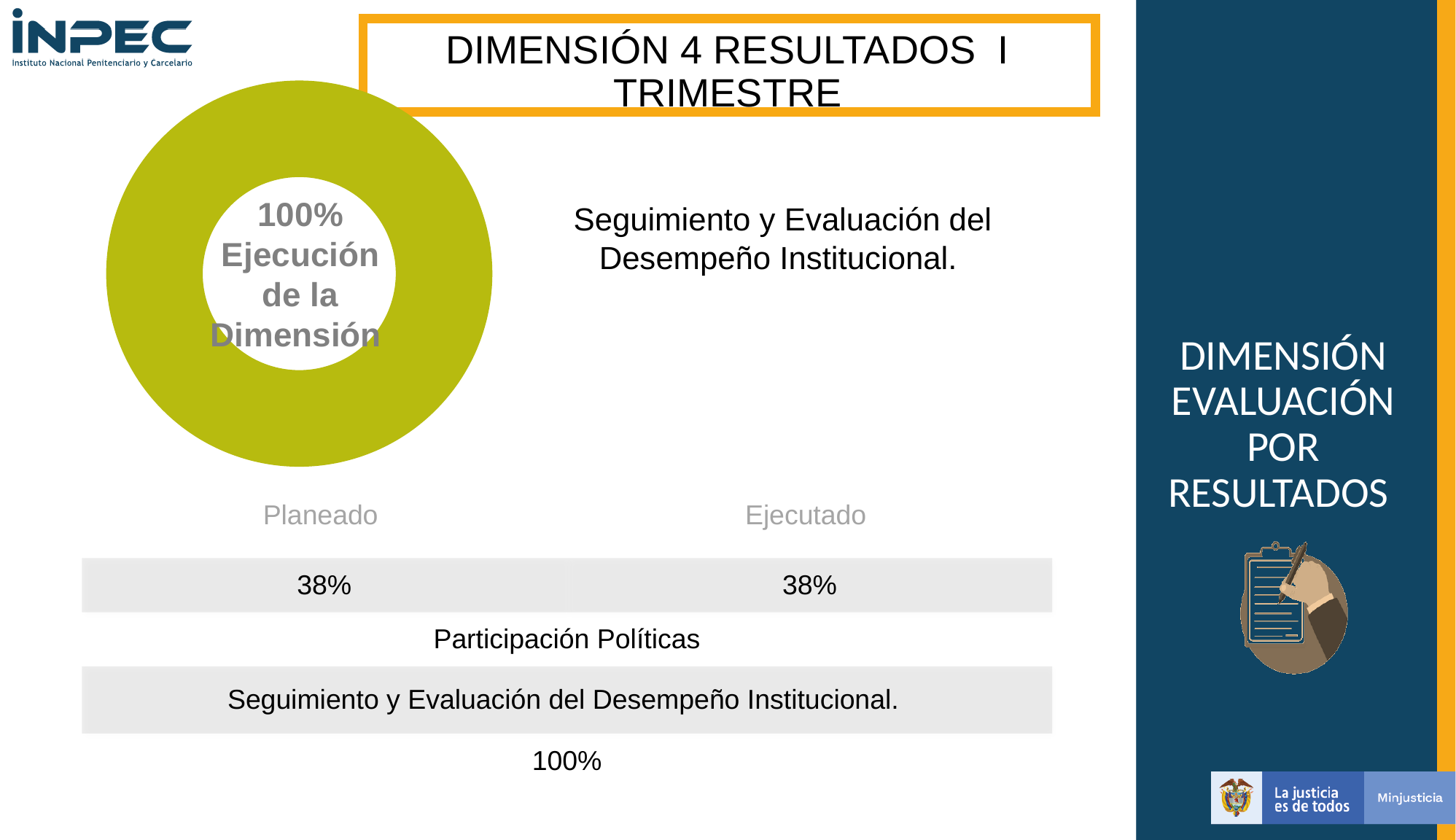
What share of the donut chart does the single slice occupy? 100% In the table below the chart, what is the Ejecutado value? 38% What percentage is printed in the centre of the donut chart? 100% What kind of chart is shown on the left of the slide? Pie (donut) chart Is the value shown in the donut chart greater or less than 50%? greater What value is printed under 'Seguimiento y Evaluación del Desempeño Institucional.' in the table below the chart? 100% What colour is the slice of the donut chart? Olive green In the table below the chart, what is the Planeado value? 38% What does the label in the centre of the donut chart say? 100% Ejecución de la Dimensión How many slices does the donut chart contain? 1 In the table below the chart, what is the difference between the Planeado and Ejecutado values? 0%